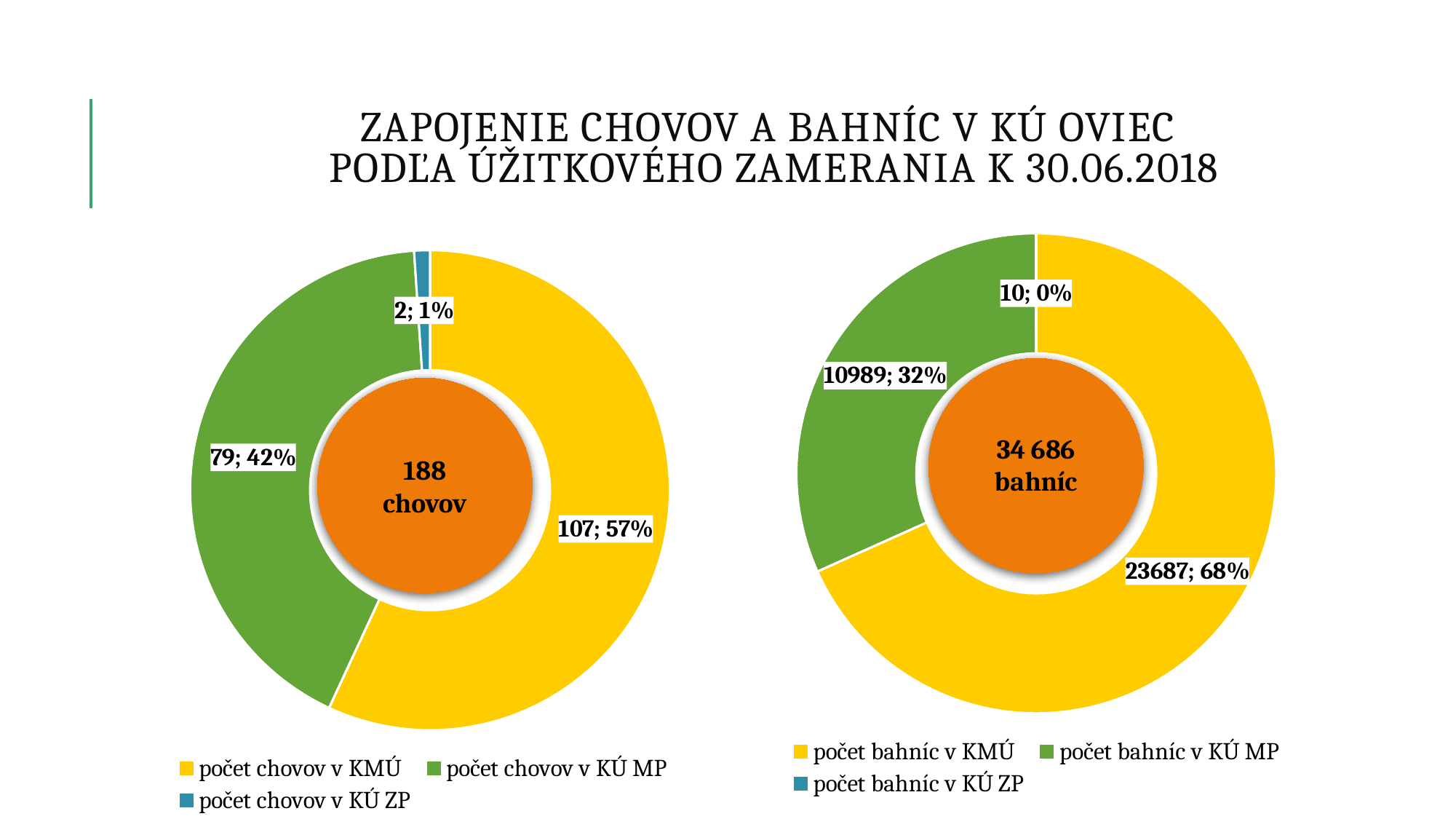
How many categories does the legend of the left chart (188 chovov) list? 3 In the left chart (188 chovov), which category has the smallest slice? počet chovov v KÚ ZP What type of chart is the right chart (34 686 bahníc)? Pie (doughnut) chart In the right chart (34 686 bahníc), what is the value for počet bahníc v KÚ ZP? 10 In the right chart (34 686 bahníc), which category has the largest slice? počet bahníc v KMÚ In the left chart (188 chovov), what is the value for počet chovov v KÚ ZP? 2 In the right chart (34 686 bahníc), what share of the pie is počet bahníc v KMÚ? 68% In the right chart (34 686 bahníc), what is the difference between počet bahníc v KMÚ and počet bahníc v KÚ MP? 12698 In the left chart (188 chovov), what is the difference between počet chovov v KMÚ and počet chovov v KÚ MP? 28 In the left chart (188 chovov), what share of the pie is počet chovov v KÚ MP? 42% In the right chart (34 686 bahníc), what is the value for počet bahníc v KÚ MP? 10989 In the left chart (188 chovov), what is the value for počet chovov v KMÚ? 107